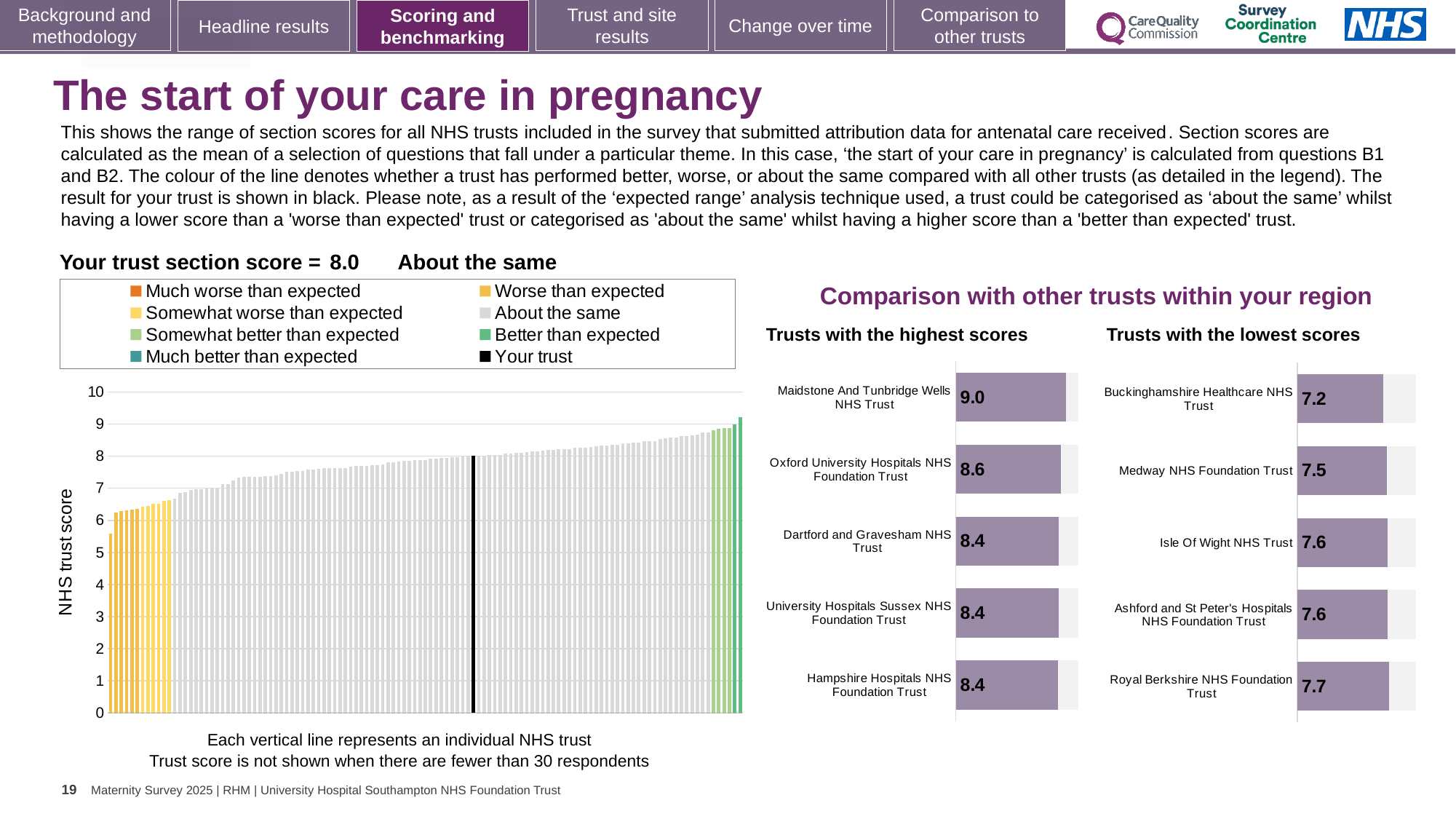
How many entries does the legend of the main 'NHS trust score' chart list? 8 In the 'Trusts with the highest scores' chart, what is the score for Maidstone And Tunbridge Wells NHS Trust? 9.0 In the 'Trusts with the highest scores' chart, which trust has the highest score? Maidstone And Tunbridge Wells NHS Trust In the main 'NHS trust score' chart on the left, what is the section score for your trust? 8.0 In the 'Trusts with the lowest scores' chart, which trust has the lowest score? Buckinghamshire Healthcare NHS Trust What is the difference between the score for Maidstone And Tunbridge Wells NHS Trust in the highest scores chart and the score for Buckinghamshire Healthcare NHS Trust in the lowest scores chart? 1.8 In the 'Trusts with the lowest scores' chart, what is the score for Buckinghamshire Healthcare NHS Trust? 7.2 In the main 'NHS trust score' chart on the left, do the bar values rise or fall from left to right? rise In the 'Trusts with the lowest scores' chart, which has the larger score: Medway NHS Foundation Trust or Royal Berkshire NHS Foundation Trust? Royal Berkshire NHS Foundation Trust In the 'Trusts with the lowest scores' chart, what is the score for Royal Berkshire NHS Foundation Trust? 7.7 How many trusts are shown in the 'Trusts with the highest scores' chart? 5 In the 'Trusts with the highest scores' chart, what is the score for Oxford University Hospitals NHS Foundation Trust? 8.6